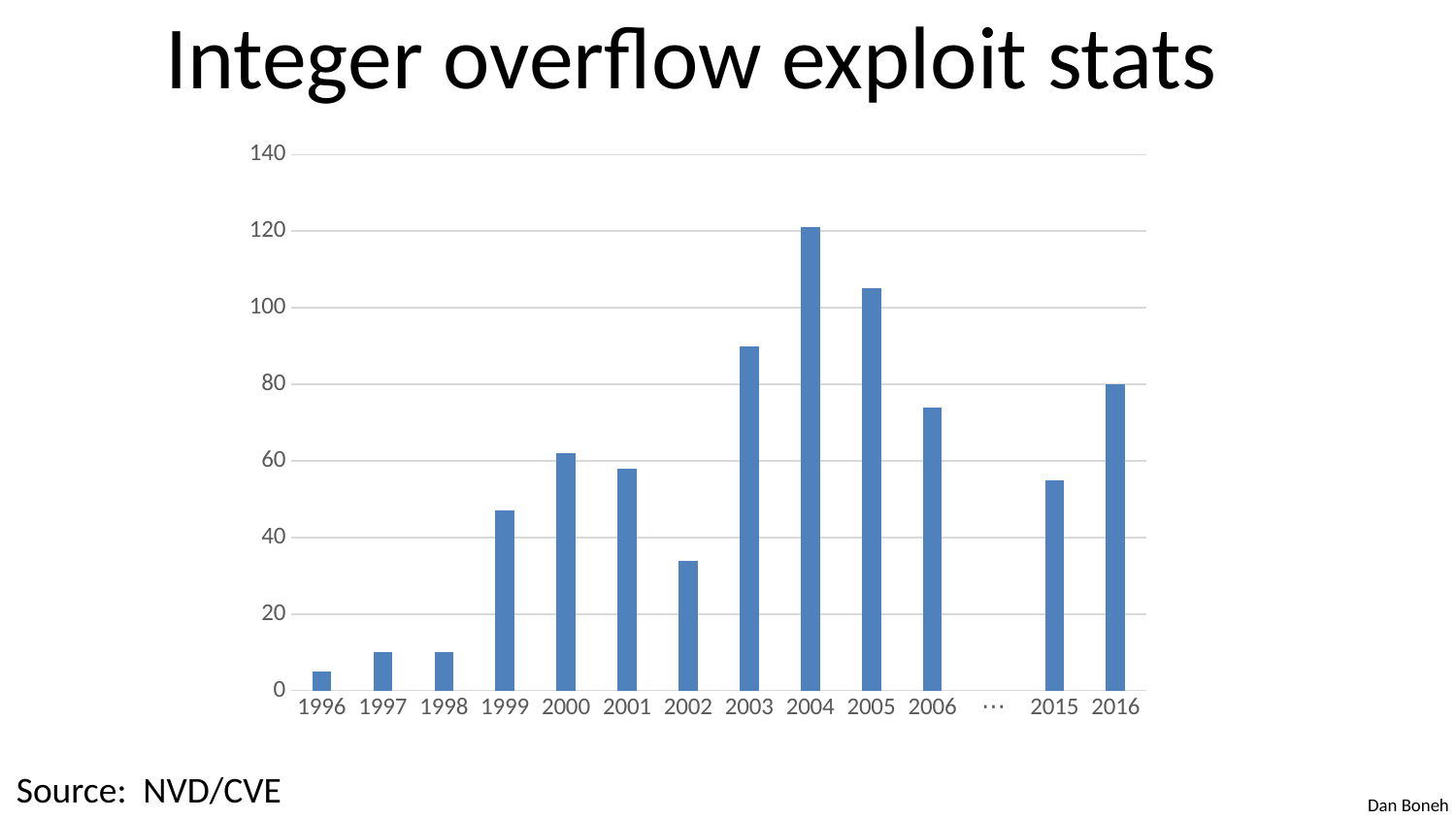
Is the value for 2002 greater or less than 40? less Which year has the highest bar? 2004 Which year has the larger value, 1999 or 2002? 1999 Is the value for 2004 greater or less than 100? greater Which year has the lowest bar? 1996 Do the values generally rise or fall from 1996 to 2004? rise What kind of chart is shown on the slide? bar chart Which year has the larger value, 2003 or 2005? 2005 What source is cited for the chart data? NVD/CVE Is the value for 2006 greater or less than 60? greater What is the title of the chart? Integer overflow exploit stats